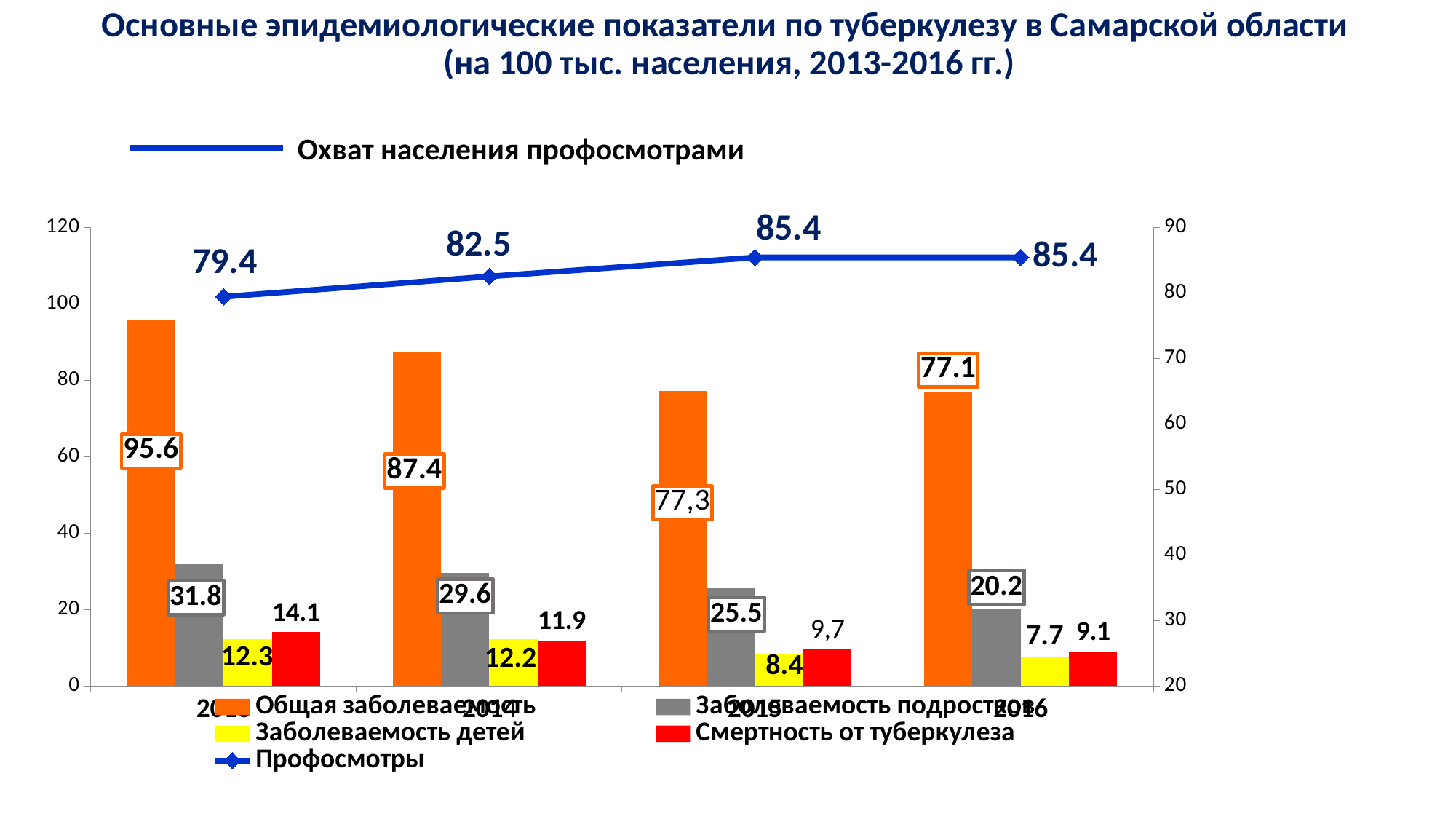
What is the value of Общая заболеваемость in 2013? 95.6 What is the value of Заболеваемость подростков in 2016? 20.2 Does the Профосмотры line rise or fall from 2013 to 2016? rise What is the value of Смертность от туберкулеза in 2015? 9,7 In which year is Заболеваемость детей lowest? 2016 What is the value of the Профосмотры line in 2014? 82.5 In which year is Общая заболеваемость highest? 2013 How many years are shown on the x axis? 4 How many series does the legend list? 5 What colour are the Заболеваемость детей bars? yellow What is the difference between Общая заболеваемость in 2013 and in 2014? 8.2 Which is larger in 2013: Заболеваемость детей or Смертность от туберкулеза? Смертность от туберкулеза